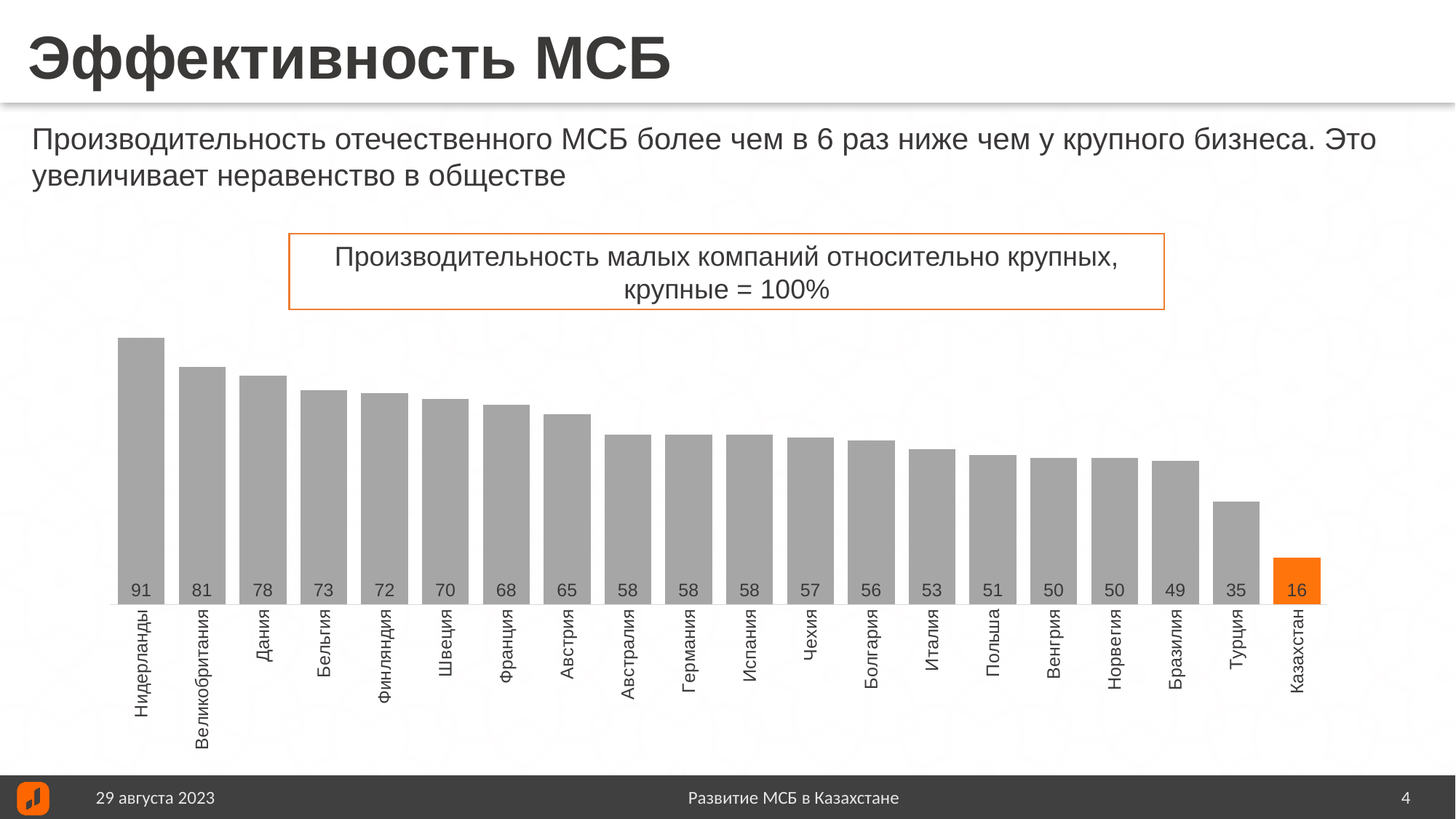
What is the difference between the values for Нидерланды and Казахстан? 75 How many countries are shown in the chart? 20 Which country has the highest value? Нидерланды What is the difference between the values for Великобритания and Дания? 3 Which is larger, the value for Бельгия or the value for Польша? Бельгия Do the values rise or fall from left to right along the x axis? fall What is the value for Турция? 35 What is the value for Казахстан? 16 Which bar is highlighted in orange? Казахстан What is the value for Германия? 58 Which country has the lowest value? Казахстан What kind of chart is shown on the slide? bar chart